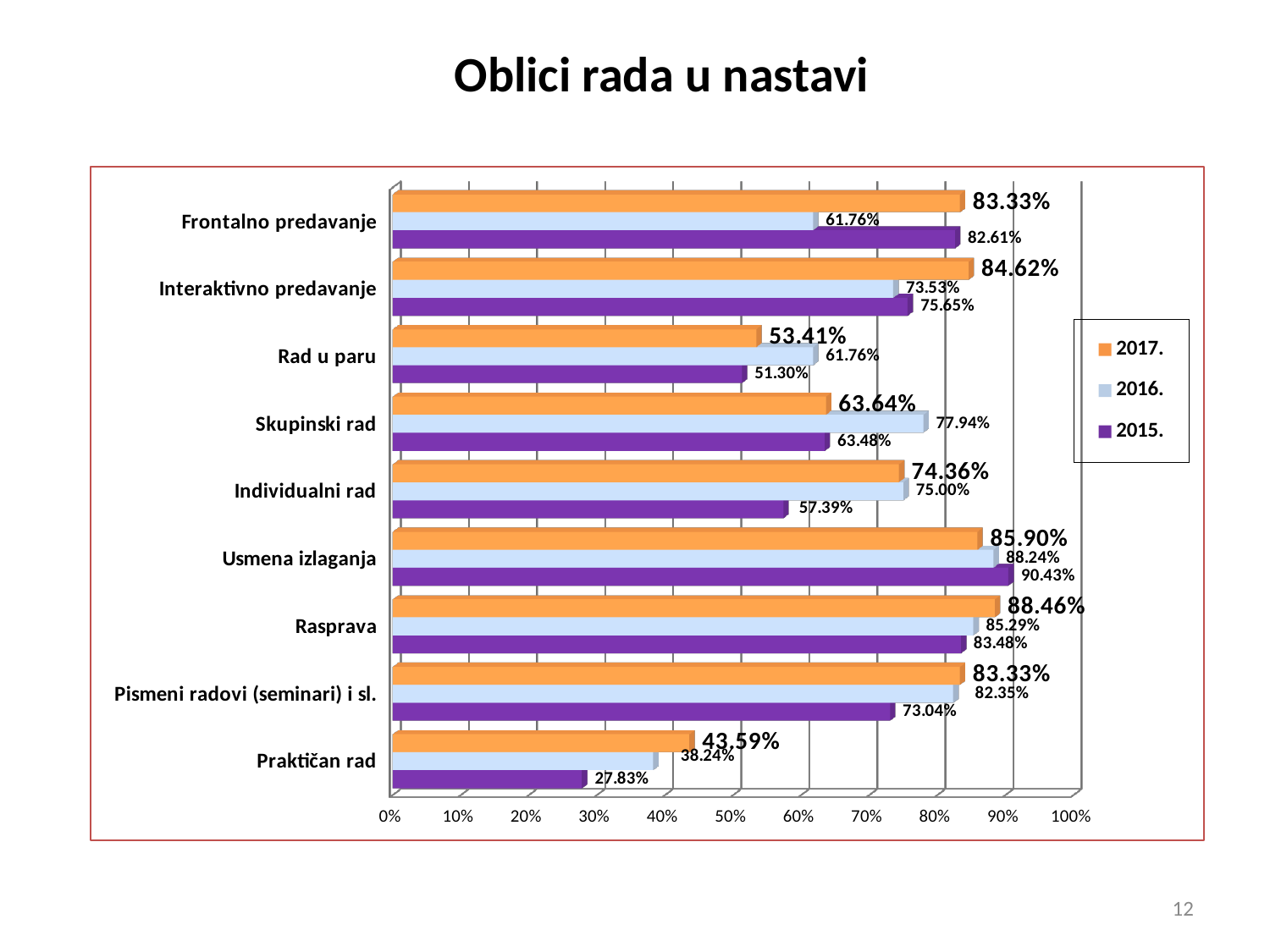
What is the 2017. value for Rasprava? 88.46% What is the difference between the 2017. and 2016. values for Frontalno predavanje? 21.57 percentage points What is the title of the slide? Oblici rada u nastavi For Skupinski rad, which is larger: the 2016. value or the 2017. value? 2016. How many series does the legend list? 3 How many categories are shown on the chart? 9 What type of chart is shown on the slide? Bar chart Which category has the highest 2017. value? Rasprava Which category has the lowest 2015. value? Praktičan rad Which category has the highest 2015. value? Usmena izlaganja What is the 2016. value for Skupinski rad? 77.94% What is the 2015. value for Praktičan rad? 27.83%